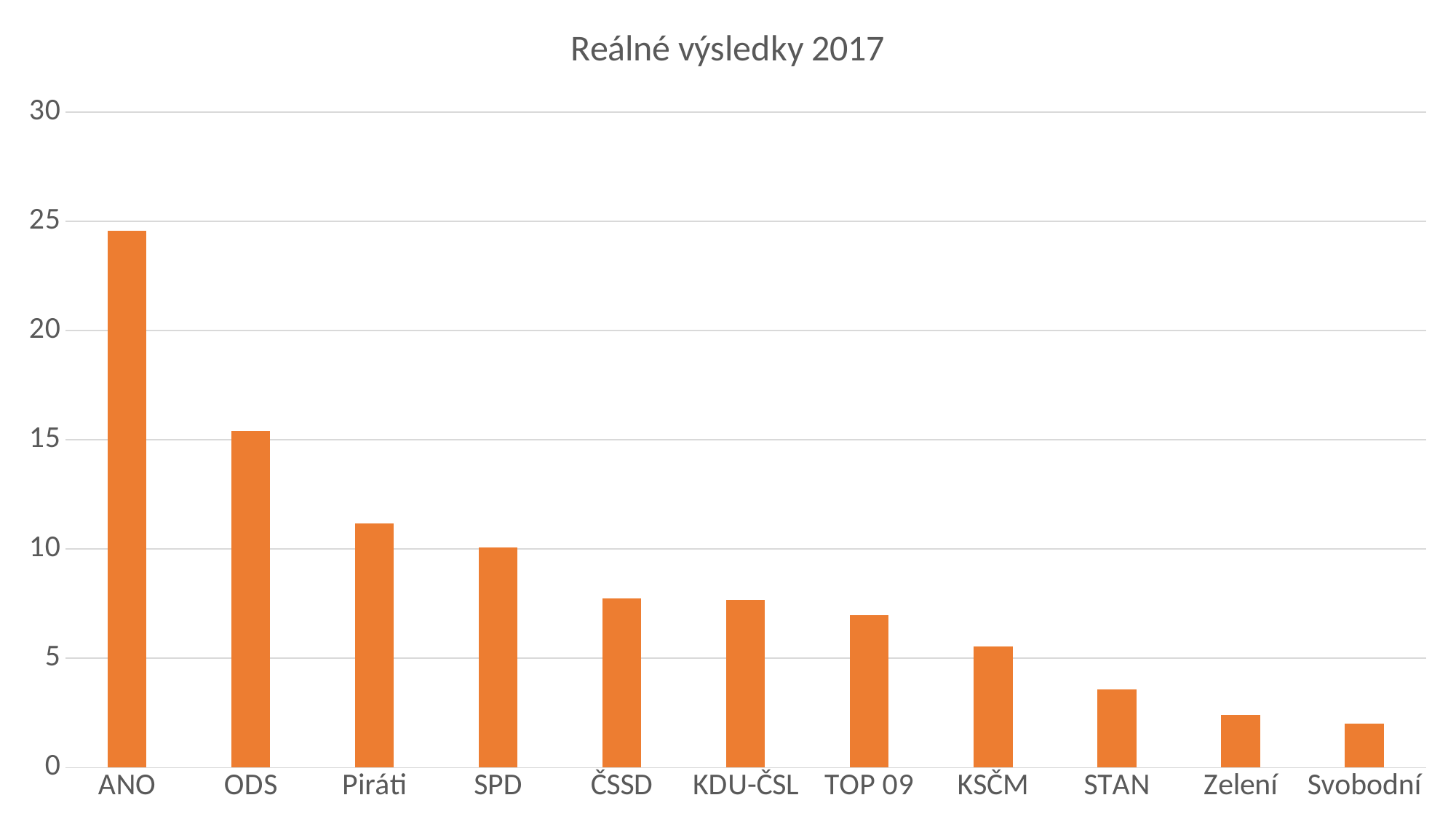
Which party has the highest value? ANO Which party has the lowest value? Svobodní Is the value for TOP 09 greater or less than 5? greater Is the value for STAN greater or less than 5? less Is the value for ANO greater or less than 20? greater Which is larger, the value for ODS or the value for Piráti? ODS What type of chart is shown on the slide? bar chart How many parties (categories) are shown on the x axis? 11 Do the values rise or fall moving from left to right along the x axis? fall What is the title of the chart? Reálné výsledky 2017